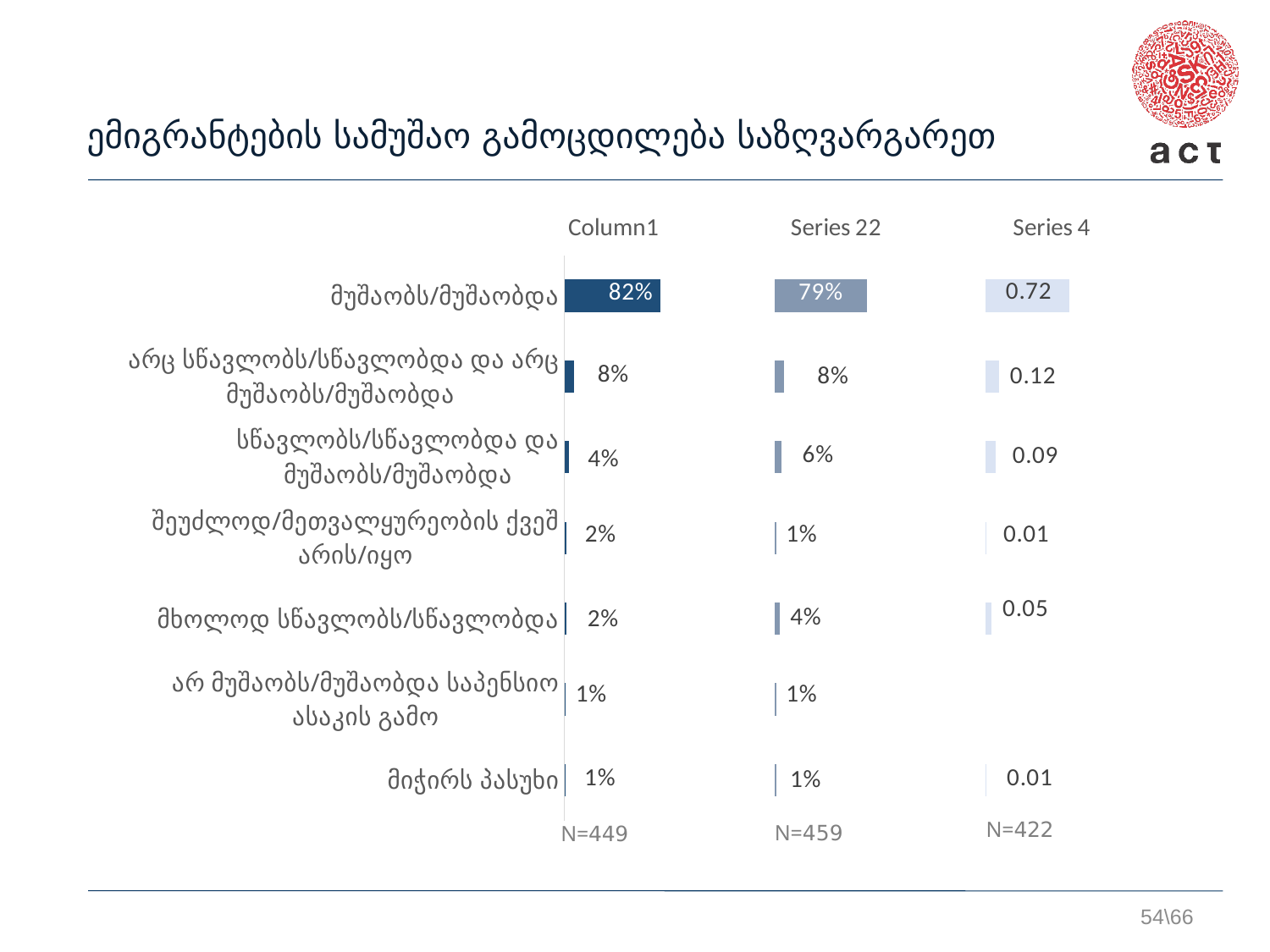
What is the Series 4 value for არც სწავლობს/სწავლობდა და არც მუშაობს/მუშაობდა? 0.12 Which category has the highest Column1 value? მუშაობს/მუშაობდა How many series does the chart show? 3 What kind of chart is shown on the slide? bar chart How many categories are shown in the chart? 7 What is the Column1 value for მუშაობს/მუშაობდა? 82% What is the Series 22 value for მუშაობს/მუშაობდა? 79% What is the N shown under the Series 22 column? N=459 What is the difference between the Column1 and Series 22 values for მუშაობს/მუშაობდა? 3% What is the Series 22 value for სწავლობს/სწავლობდა და მუშაობს/მუშაობდა? 6% What is the Series 4 value for მუშაობს/მუშაობდა? 0.72 Which is larger for მხოლოდ სწავლობს/სწავლობდა: the Column1 value or the Series 22 value? Series 22